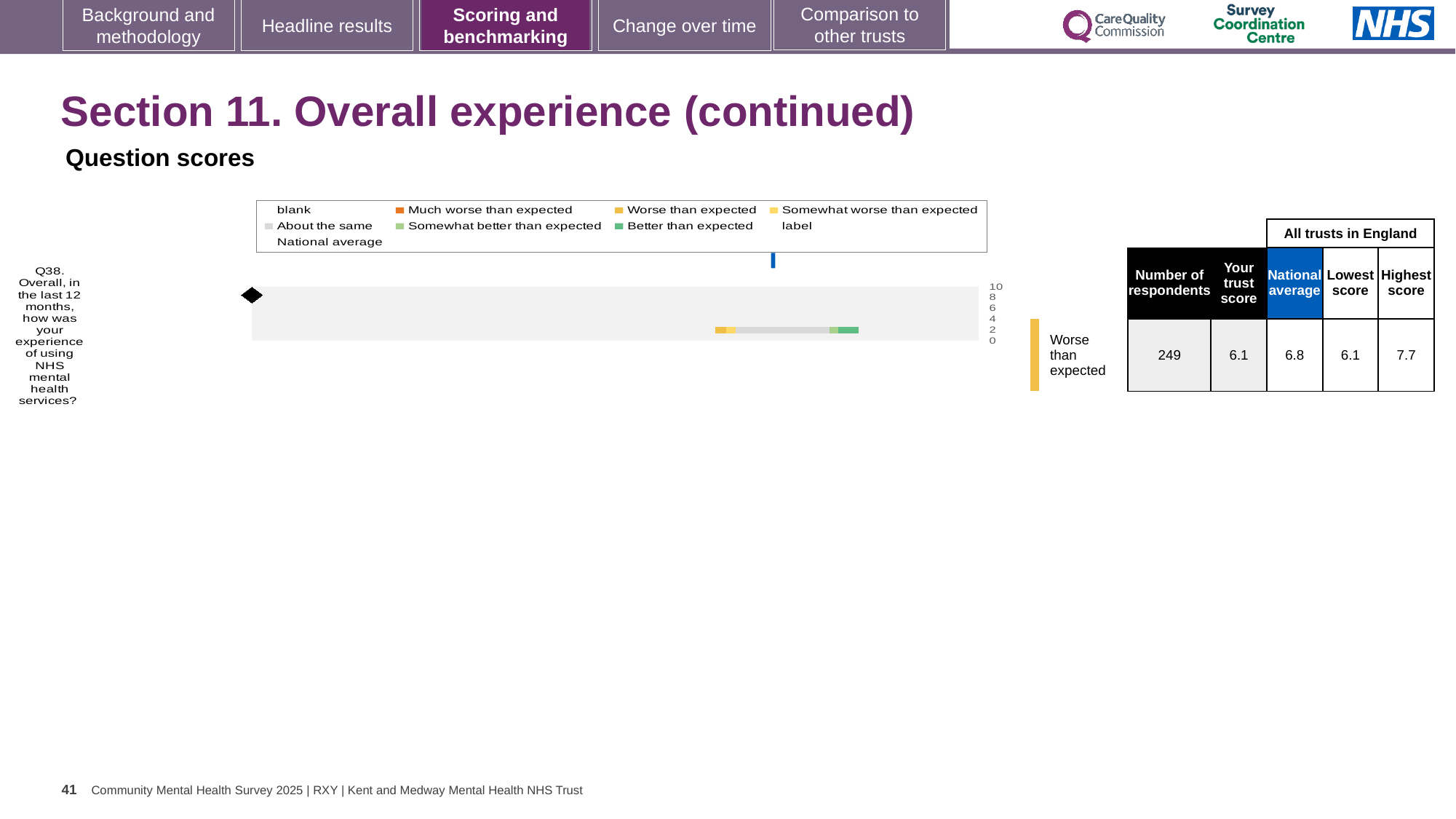
What kind of chart is shown on the slide? bar chart What is the highest score among all trusts in England for Q38? 7.7 What is the national average score for Q38? 6.8 What is the lowest score among all trusts in England for Q38? 6.1 Which is larger for Q38, the trust score or the national average? national average What is the trust score for Q38? 6.1 What is the highest value shown on the chart's score axis? 10 What is the number of respondents for Q38? 249 What is the difference between the highest and lowest scores among all trusts in England for Q38? 1.6 How many survey questions are plotted in the chart? 1 What is the difference between the national average and the trust score for Q38? 0.7 What benchmark category label is shown next to the bar for Q38? Worse than expected